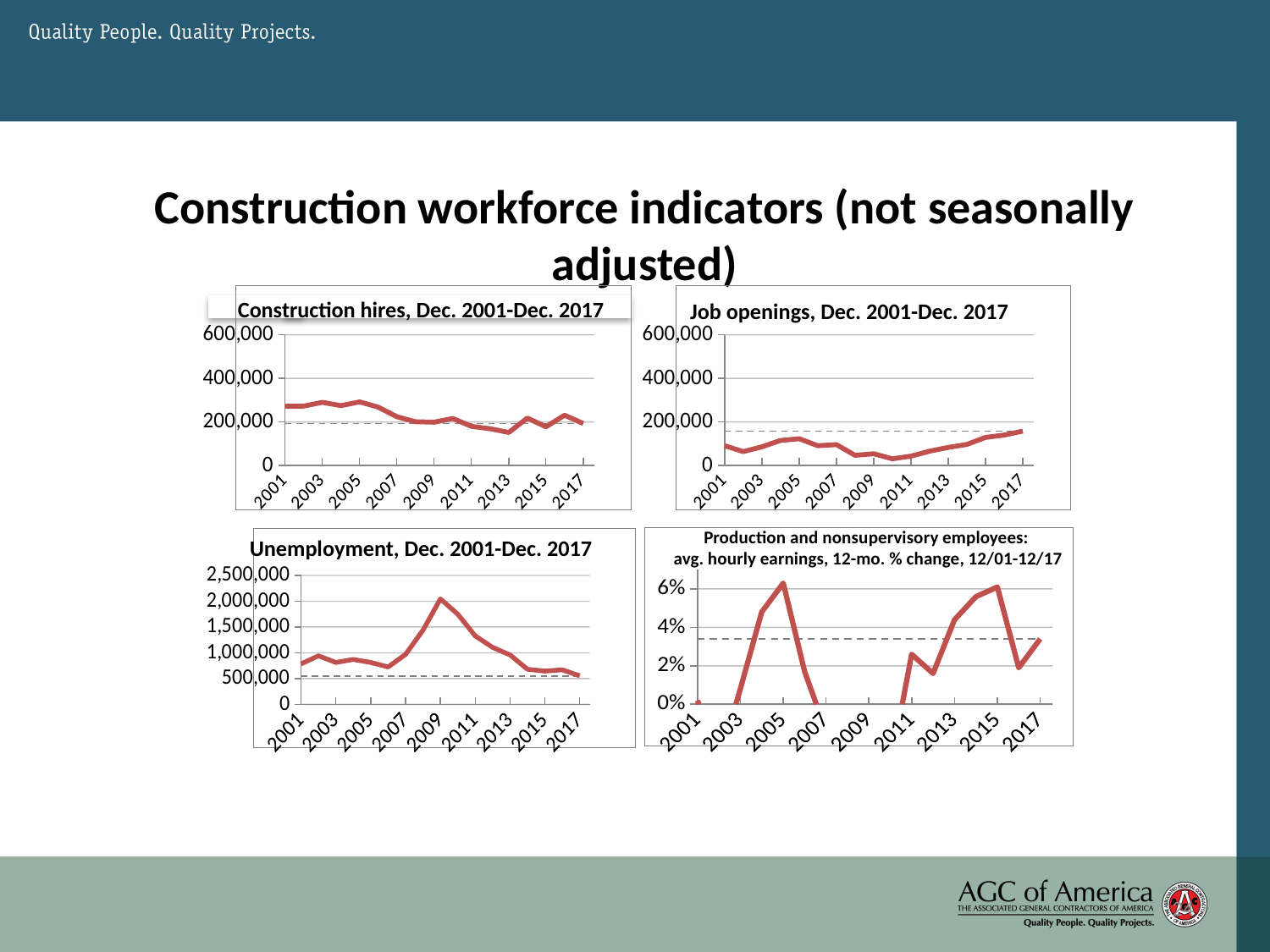
In the "Construction hires, Dec. 2001-Dec. 2017" chart, is the value for 2005 greater or less than 200,000? greater In the "Construction hires, Dec. 2001-Dec. 2017" chart, is the value for 2013 greater or less than 200,000? less In the "Job openings, Dec. 2001-Dec. 2017" chart, which year has the lowest value? 2010 In the "Job openings, Dec. 2001-Dec. 2017" chart, is the value for 2017 greater or less than 200,000? less What kind of chart is the "Construction hires, Dec. 2001-Dec. 2017" chart? line chart In the "Unemployment, Dec. 2001-Dec. 2017" chart, which year has the highest value? 2009 In the "Unemployment, Dec. 2001-Dec. 2017" chart, do values rise or fall from 2009 to 2017? fall How many charts are shown on the slide? 4 In the "Unemployment, Dec. 2001-Dec. 2017" chart, which is larger, the value for 2009 or the value for 2017? 2009 In the "Job openings, Dec. 2001-Dec. 2017" chart, do values rise or fall from 2011 to 2017? rise